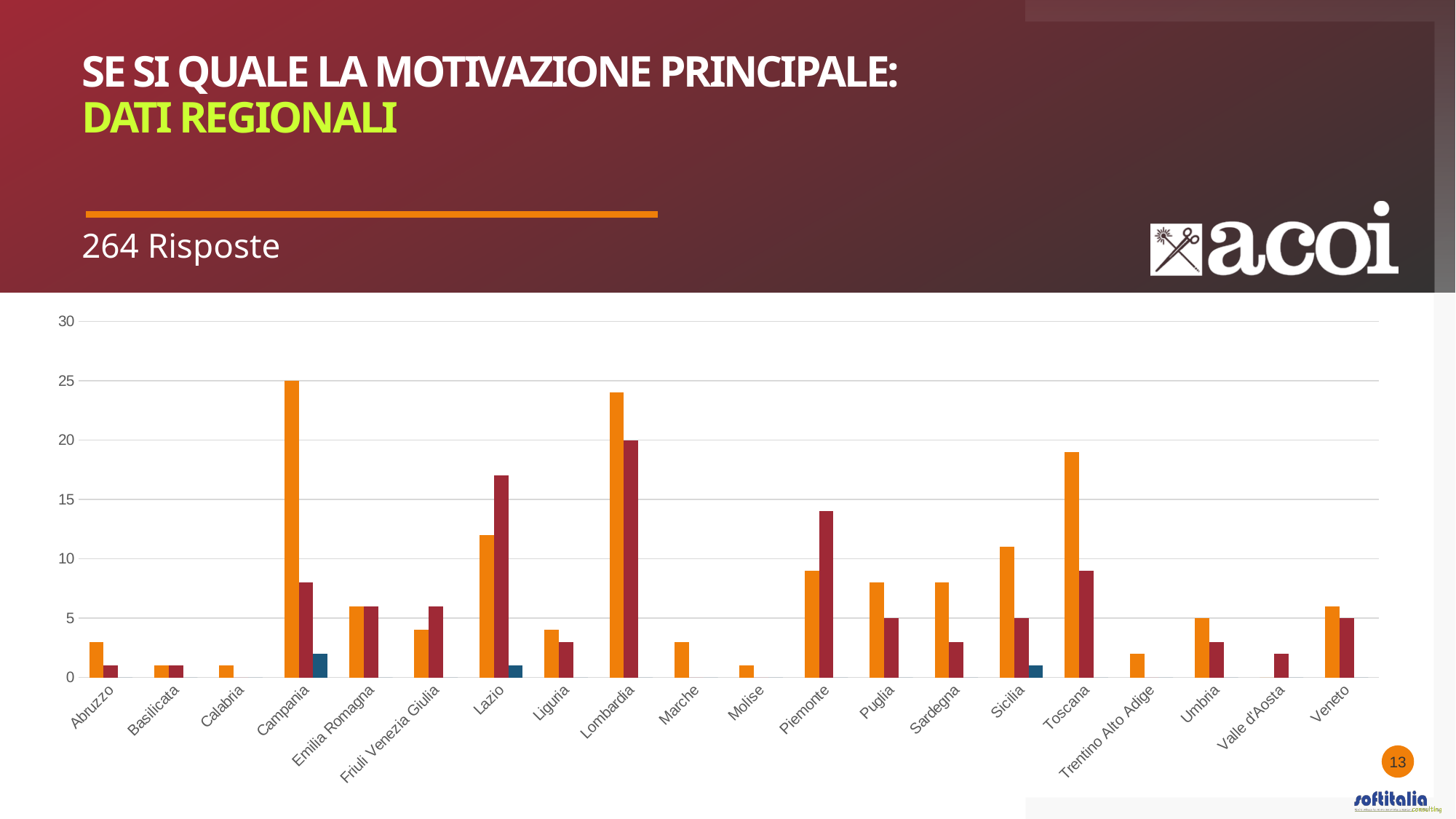
What is the value of the dark red bar for Lombardia? 20 How many responses does the slide say the chart is based on? 264 Risposte What is the value of the orange bar for Campania? 25 Is the dark red bar for Piemonte greater or less than 10? greater For Lazio, which bar is taller, the orange one or the dark red one? the dark red one Is the orange bar for Toscana greater or less than 15? greater How many regions are shown on the x axis of the chart? 20 Which region has the tallest orange bar? Campania Which region has a taller orange bar, Toscana or Piemonte? Toscana Is the dark red bar for Lazio greater or less than 15? greater What kind of chart is shown on the slide? bar chart Which region has the tallest dark red bar? Lombardia